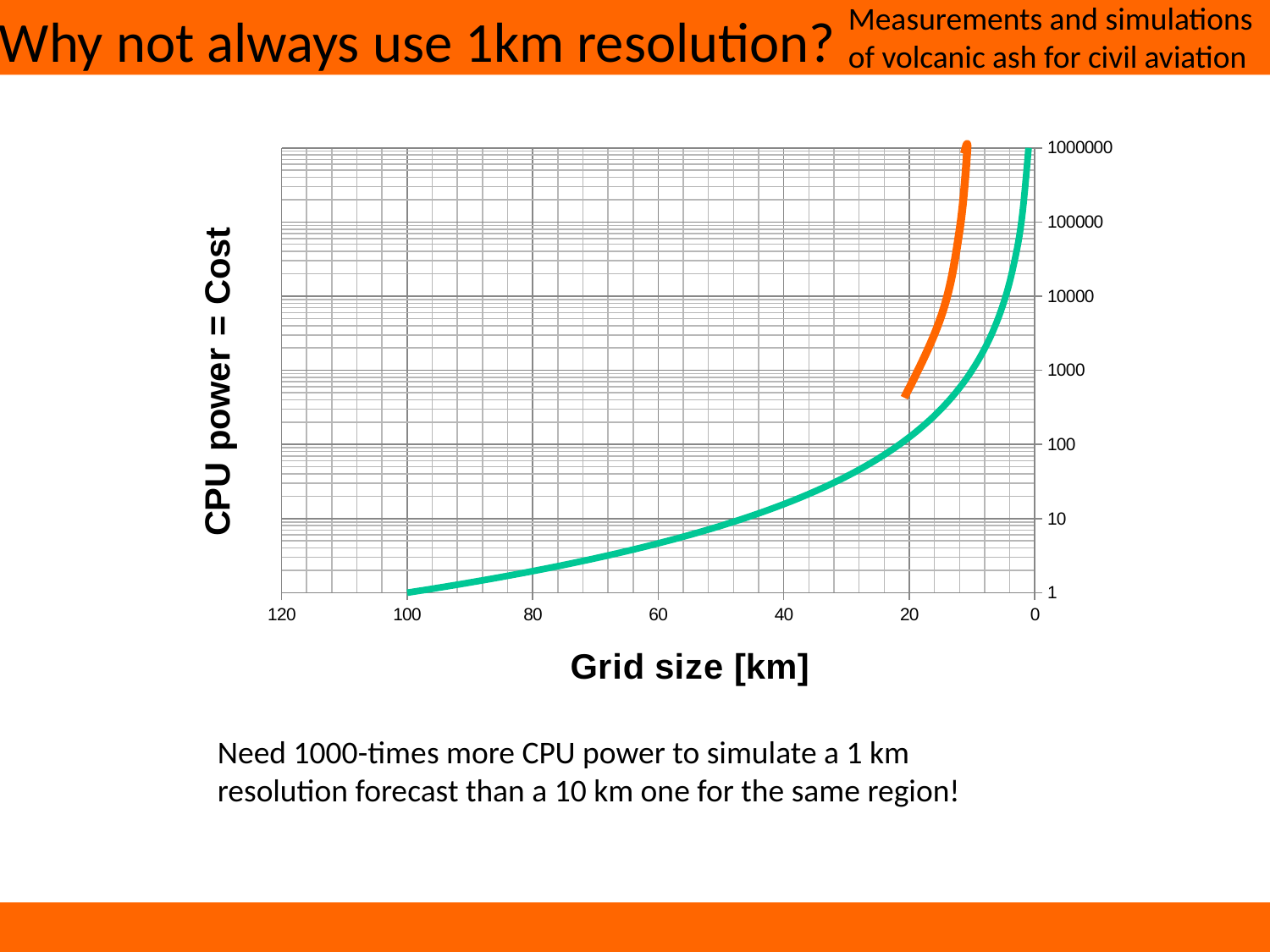
Is the value of the green line at a grid size of 60 km greater or less than 10? less At a grid size of 20 km, which line has the higher value, the orange line or the green line? the orange line Is the value of the green line at a grid size of 80 km greater or less than 10? less How many lines are plotted on the chart? 2 What is the label of the vertical axis? CPU power = Cost Is the value of the orange line at a grid size of 20 km greater or less than 100? greater What is the highest value shown on the vertical axis? 1000000 What kind of chart is shown on the slide? line chart Moving from left to right along the x axis (from grid size 120 km toward 0 km), do the plotted values rise or fall? rise What is the label of the horizontal axis? Grid size [km]